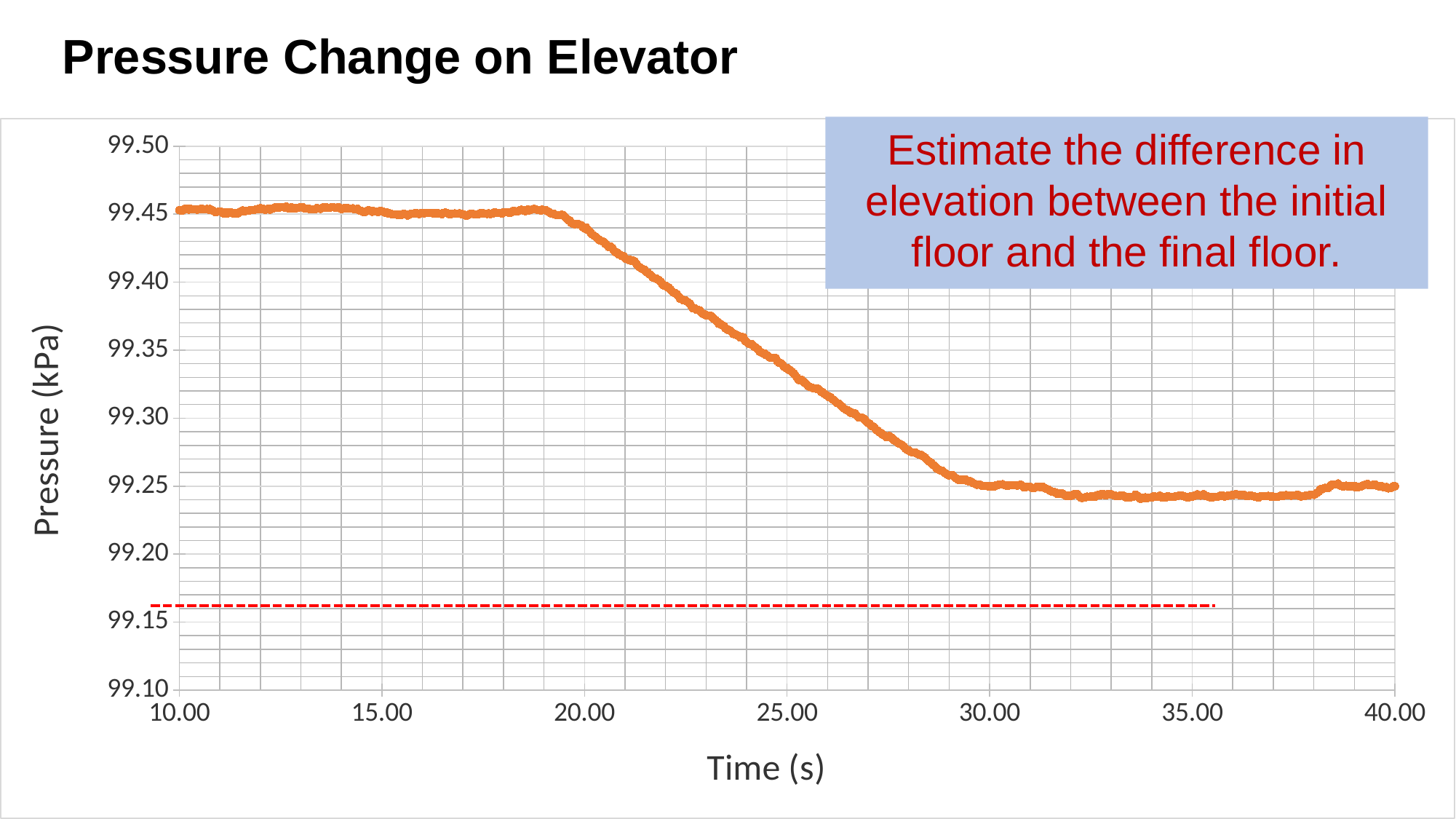
Is the pressure at 25.00 s greater or less than 99.40 kPa? less Overall, does the pressure rise or fall as time increases from 10.00 s to 40.00 s? fall Is the pressure at 15.00 s greater or less than 99.40 kPa? greater Which is larger, the pressure at 15.00 s or the pressure at 35.00 s? 15.00 s Which is larger, the pressure at 25.00 s or the pressure at 20.00 s? 20.00 s Is the pressure at 20.00 s greater or less than 99.40 kPa? greater What kind of chart is shown on the slide? line chart Between 20.00 s and 30.00 s, does the pressure rise or fall? fall What is the title of the chart? Pressure Change on Elevator What is the label of the vertical axis? Pressure (kPa)